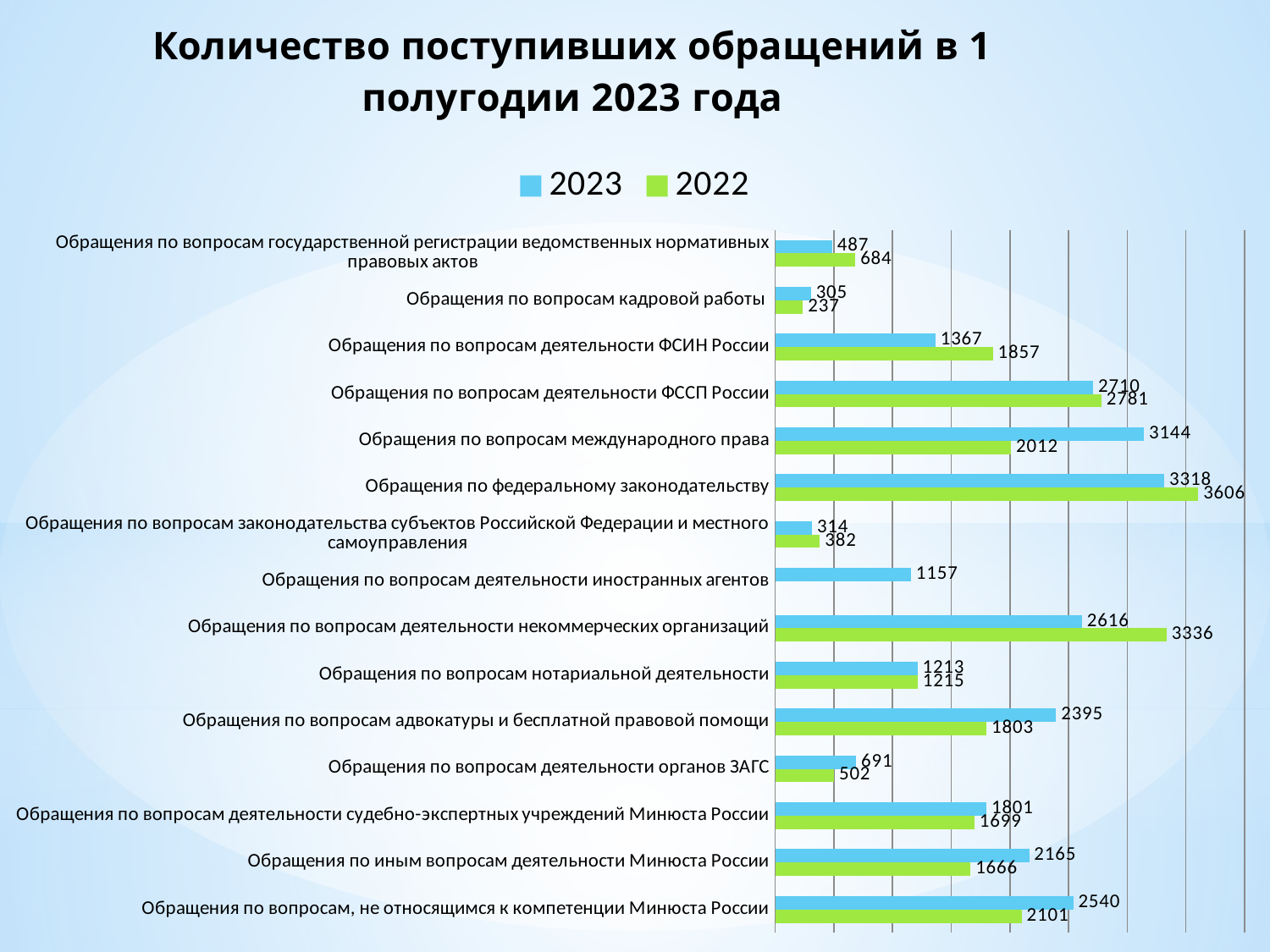
How many series does the legend list? 2 What type of chart is shown on the slide? bar chart What is the difference between the 2023 and 2022 values for 'Обращения по вопросам адвокатуры и бесплатной правовой помощи'? 592 How many categories are shown on the chart? 15 What is the 2023 value for 'Обращения по вопросам деятельности иностранных агентов'? 1157 What is the 2022 value for 'Обращения по вопросам деятельности некоммерческих организаций'? 3336 Which category has the highest 2023 value? Обращения по федеральному законодательству What is the 2023 value for 'Обращения по вопросам международного права'? 3144 Which colour represents the 2022 series in the legend? green What is the difference between the 2022 and 2023 values for 'Обращения по федеральному законодательству'? 288 For 'Обращения по вопросам деятельности ФСИН России', which year has the larger value, 2023 or 2022? 2022 Which category has the lowest 2022 value? Обращения по вопросам кадровой работы